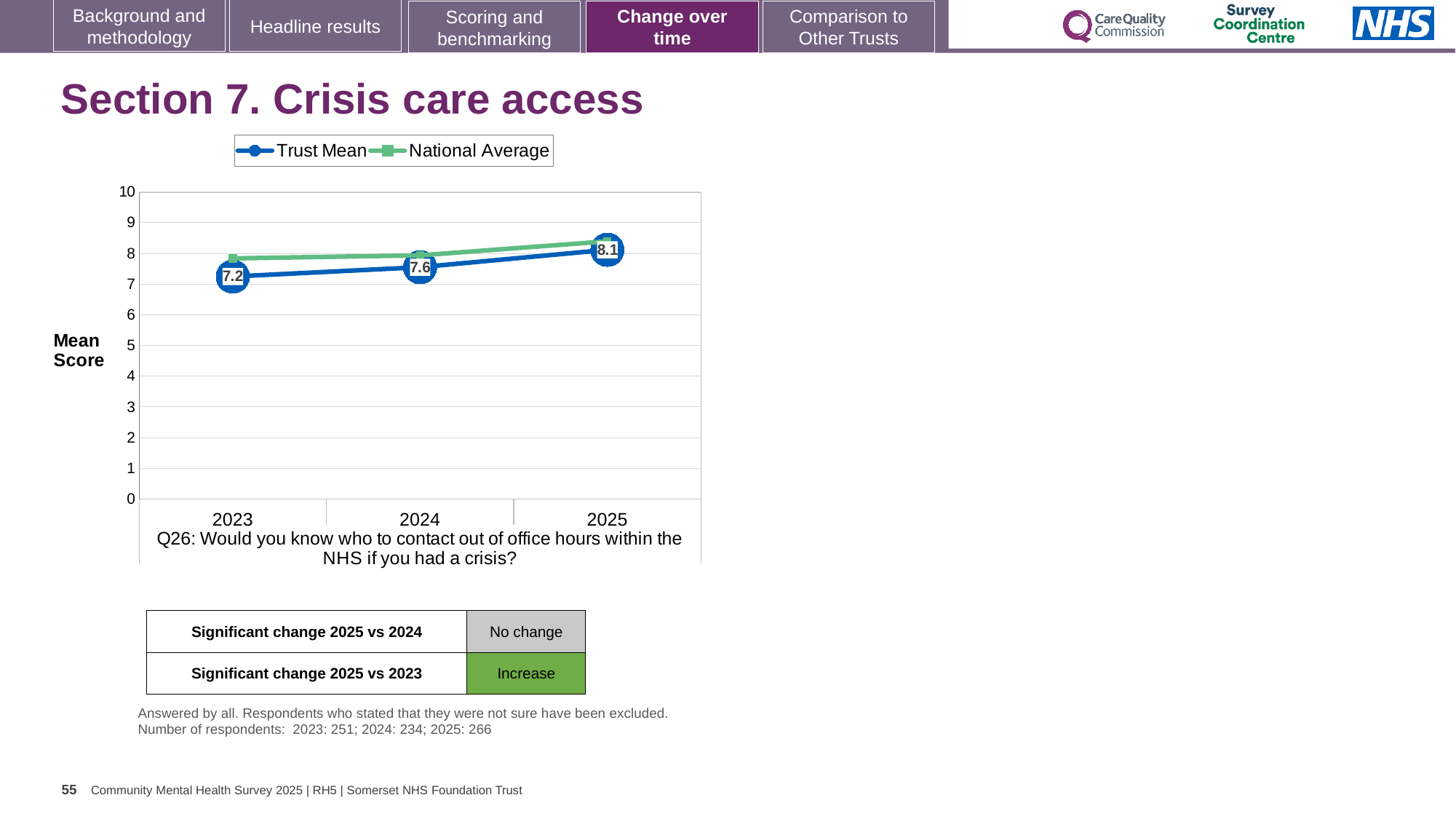
In which year is the Trust Mean score highest? 2025 What is the difference between the Trust Mean score in 2025 and in 2023? 0.9 What is the Trust Mean score for 2025? 8.1 Which is larger, the Trust Mean score in 2024 or in 2025? 2025 What is the Trust Mean score for 2023? 7.2 In which year is the Trust Mean score lowest? 2023 Does the Trust Mean rise or fall from 2023 to 2025? rise Is the National Average value for 2023 greater or less than 7? greater What is the Trust Mean score for 2024? 7.6 In 2023, which series has the higher value, Trust Mean or National Average? National Average How many years are shown on the x axis of the chart? 3 How many series does the chart legend list? 2